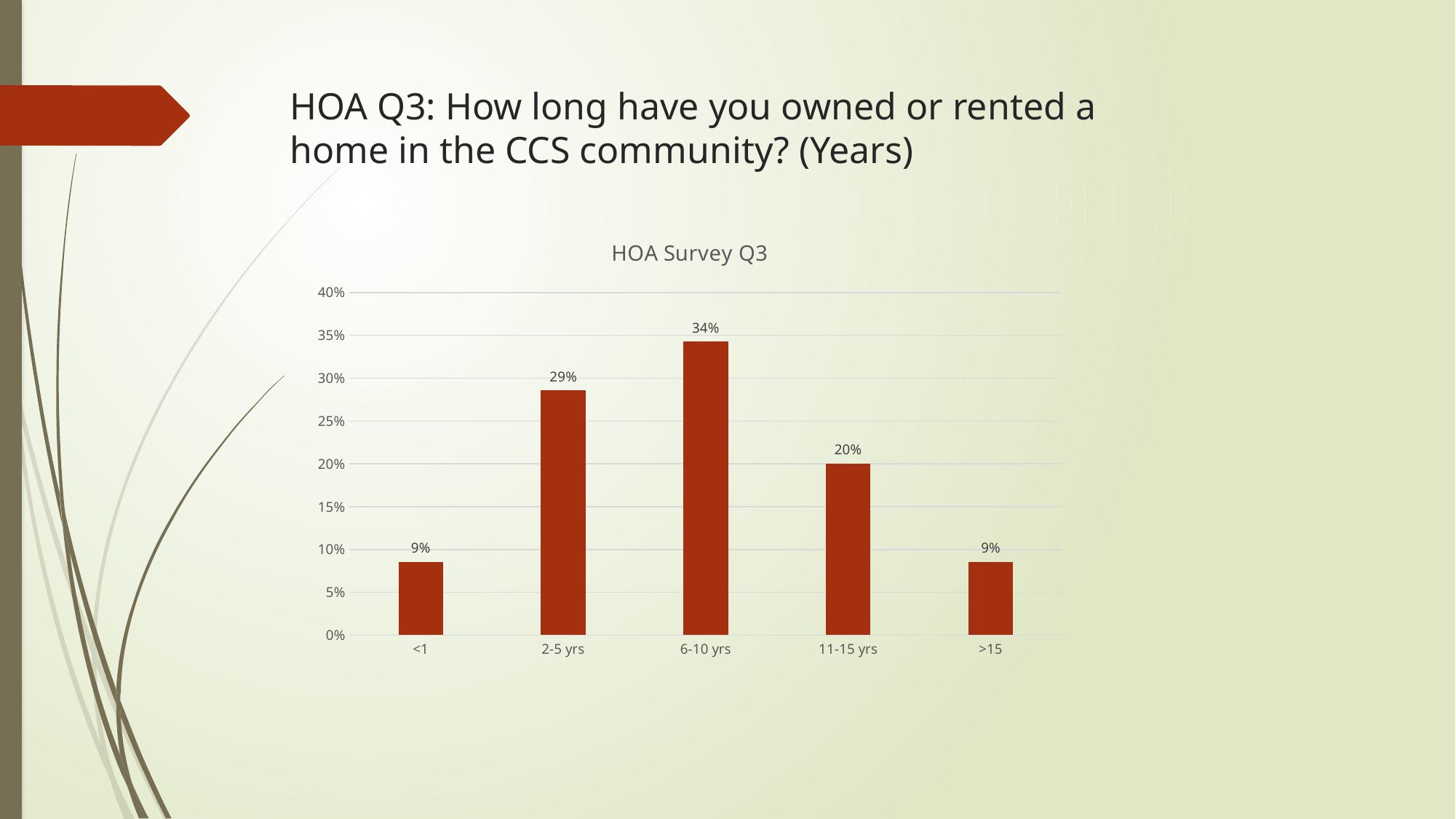
What is the difference between the values for 11-15 yrs and >15? 11% What is the value for the 11-15 yrs category? 20% Is the value for 6-10 yrs greater or less than 30%? greater What is the value for the <1 category? 9% Which category has the highest value? 6-10 yrs What is the value for the 2-5 yrs category? 29% How many categories are shown on the x axis? 5 What is the value for the 6-10 yrs category? 34% What kind of chart is shown on the slide? bar chart Which is larger, the value for 2-5 yrs or the value for 11-15 yrs? 2-5 yrs What is the difference between the values for 6-10 yrs and 2-5 yrs? 5% What is the title of the chart? HOA Survey Q3